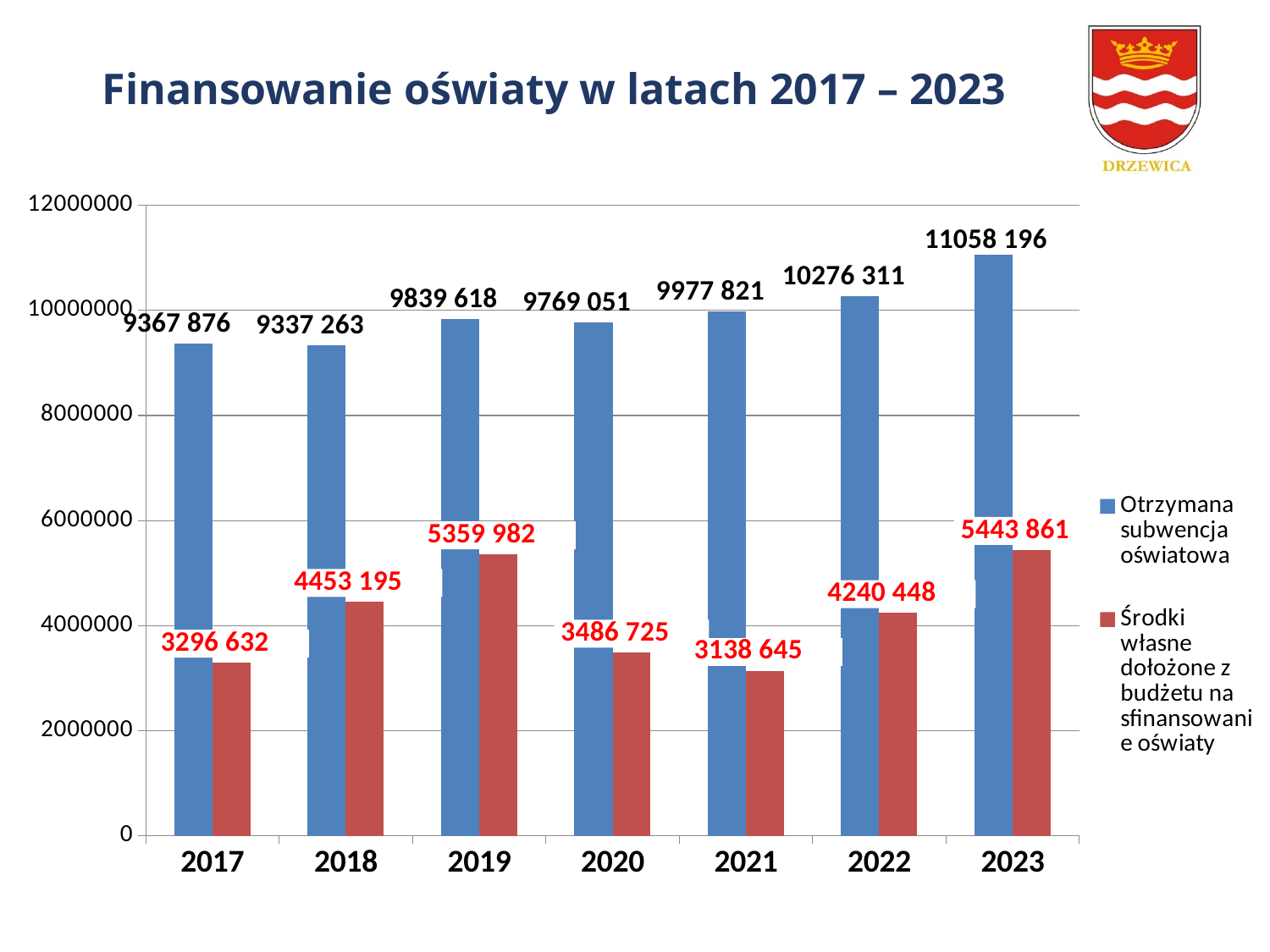
What is the value of Otrzymana subwencja oświatowa for 2023? 11058 196 Which is larger: Środki własne dołożone z budżetu in 2018 or in 2020? 2018 By how much did Środki własne dołożone z budżetu increase from 2018 to 2019? 906 787 In which year is Środki własne dołożone z budżetu na sfinansowanie oświaty the lowest? 2021 How many series does the legend list? 2 In which year is Otrzymana subwencja oświatowa the highest? 2023 How many years are shown on the x axis? 7 What is the value of Środki własne dołożone z budżetu na sfinansowanie oświaty for 2019? 5359 982 What is the difference between Otrzymana subwencja oświatowa and Środki własne dołożone z budżetu in 2023? 5614 335 What is the value of Otrzymana subwencja oświatowa for 2020? 9769 051 What kind of chart is shown on the slide? bar chart Is the value of Otrzymana subwencja oświatowa for 2022 greater or less than 10000000? greater